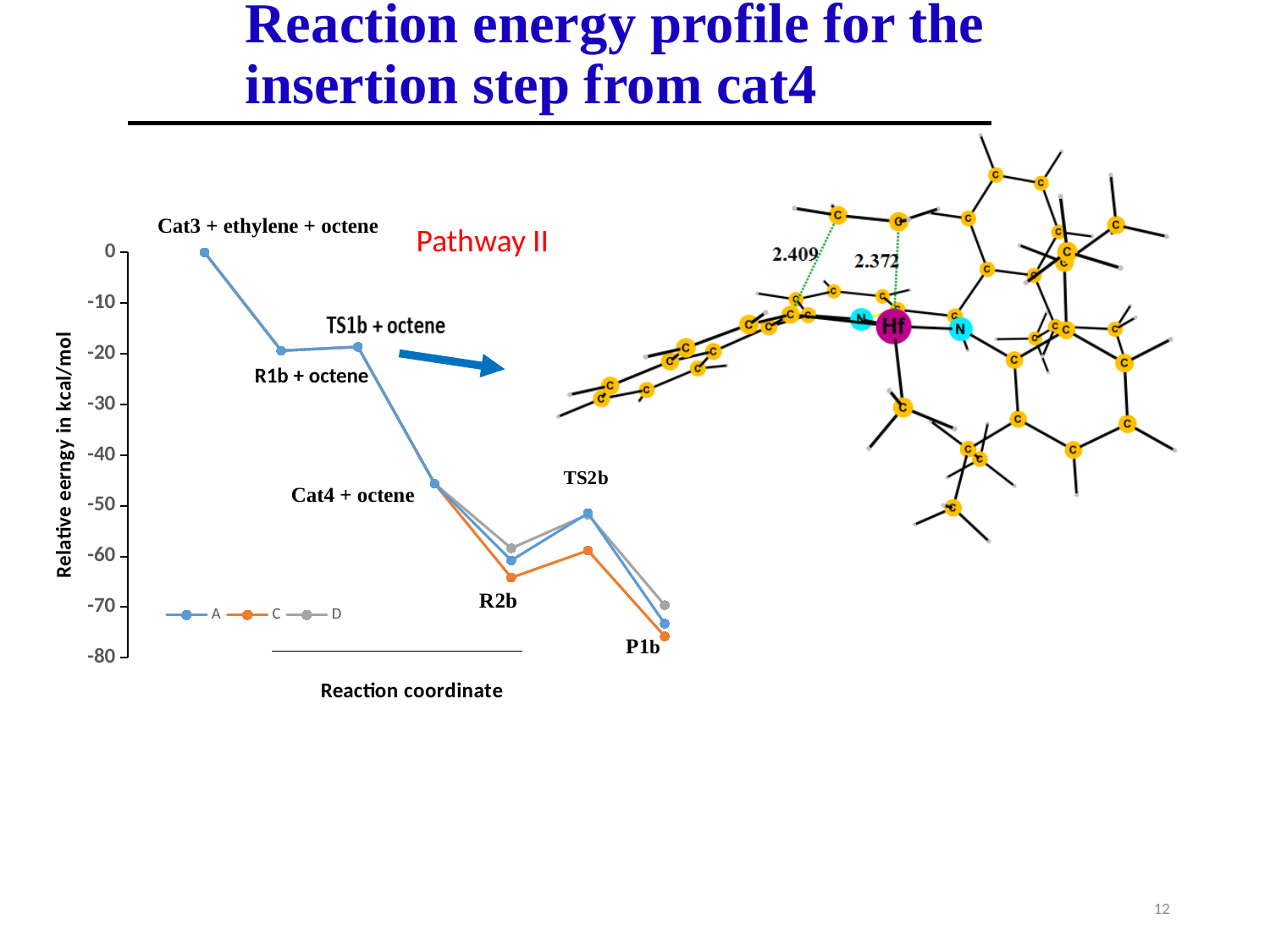
What is the title of the chart's vertical axis? Relative eerngy in kcal/mol Is the value for TS2b in series A greater or less than -60? greater What kind of chart is shown on the slide? line chart Is the value for R1b + octene greater or less than -10? less Is the value for Cat4 + octene greater or less than -40? less At R2b, which series has the lower energy, C or D? C How many series does the chart legend list? 3 What is the relative energy value at the starting point labelled Cat3 + ethylene + octene? 0 How many labelled points are there along the reaction coordinate? 7 Does the energy rise or fall from Cat3 + ethylene + octene to R1b + octene? fall What are the series names listed in the chart legend? A, C, D